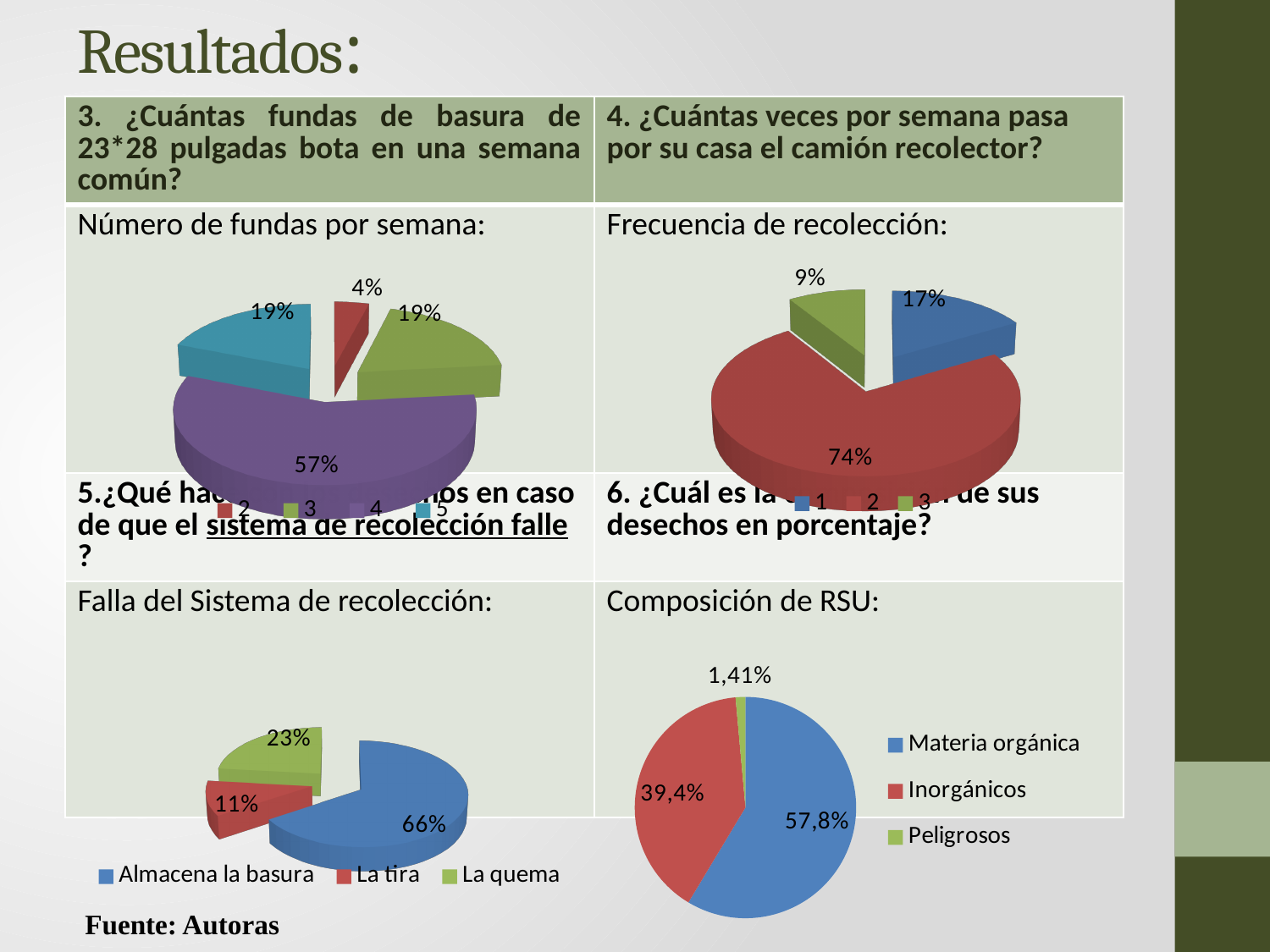
In the 'Composición de RSU' chart, what is the difference between Materia orgánica and Inorgánicos? 18,4% In the 'Composición de RSU' chart, which category has the smallest share? Peligrosos In the 'Falla del Sistema de recolección' chart, what percentage is 'La quema'? 23% How many entries does the legend of the 'Falla del Sistema de recolección' chart list? 3 In the 'Número de fundas por semana' chart, what is the largest percentage shown? 57% In the 'Falla del Sistema de recolección' chart, which is larger: 'La tira' or 'La quema'? La quema In the 'Frecuencia de recolección' chart, what percentage is category 2? 74% In the 'Frecuencia de recolección' chart, which category has the smallest share? 3 In the 'Composición de RSU' chart, what percentage is Materia orgánica? 57,8% In the 'Composición de RSU' chart, what percentage is Inorgánicos? 39,4% In the 'Falla del Sistema de recolección' chart, which category has the largest share? Almacena la basura What type of chart is the 'Composición de RSU' chart? Pie chart